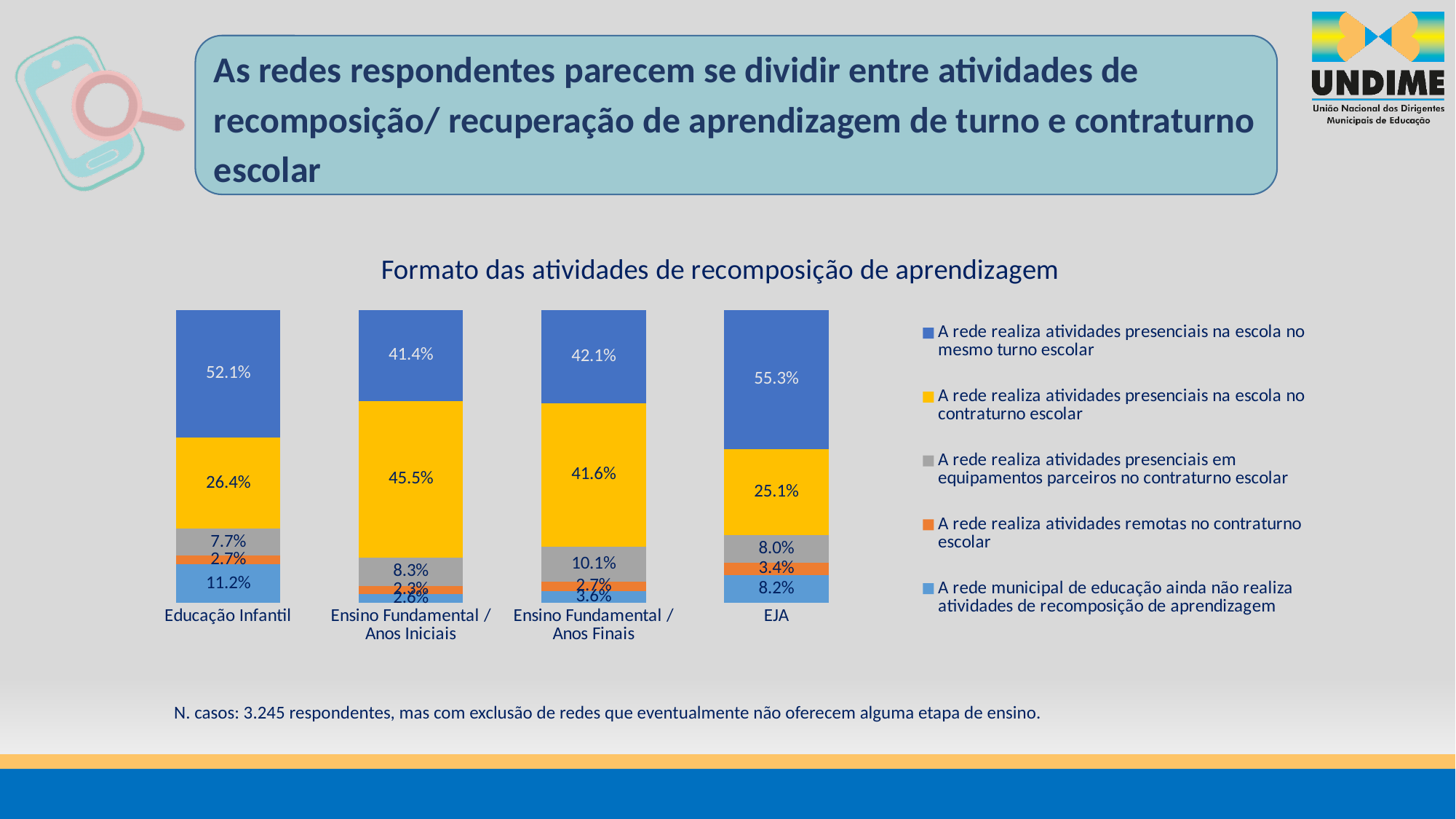
Which category has the lowest value for 'A rede realiza atividades presenciais na escola no contraturno escolar'? EJA What is the title of the chart? Formato das atividades de recomposição de aprendizagem What type of chart is shown on the slide? Stacked bar chart Which category has the highest value for 'A rede realiza atividades presenciais na escola no mesmo turno escolar'? EJA How many series does the chart legend list? 5 What is the value for 'A rede realiza atividades presenciais na escola no mesmo turno escolar' for EJA? 55.3% How many categories (education stages) are shown on the x axis of the chart? 4 What is the value for 'A rede municipal de educação ainda não realiza atividades de recomposição de aprendizagem' for Educação Infantil? 11.2% What is the value for 'A rede realiza atividades presenciais na escola no contraturno escolar' for Ensino Fundamental / Anos Iniciais? 45.5% What is the value for 'A rede realiza atividades presenciais em equipamentos parceiros no contraturno escolar' for Ensino Fundamental / Anos Finais? 10.1% What is the difference between the 'mesmo turno escolar' values for EJA and Educação Infantil? 3.2% Which is larger for Ensino Fundamental / Anos Finais: the 'mesmo turno escolar' value or the 'contraturno escolar' value? Mesmo turno escolar (42.1%)